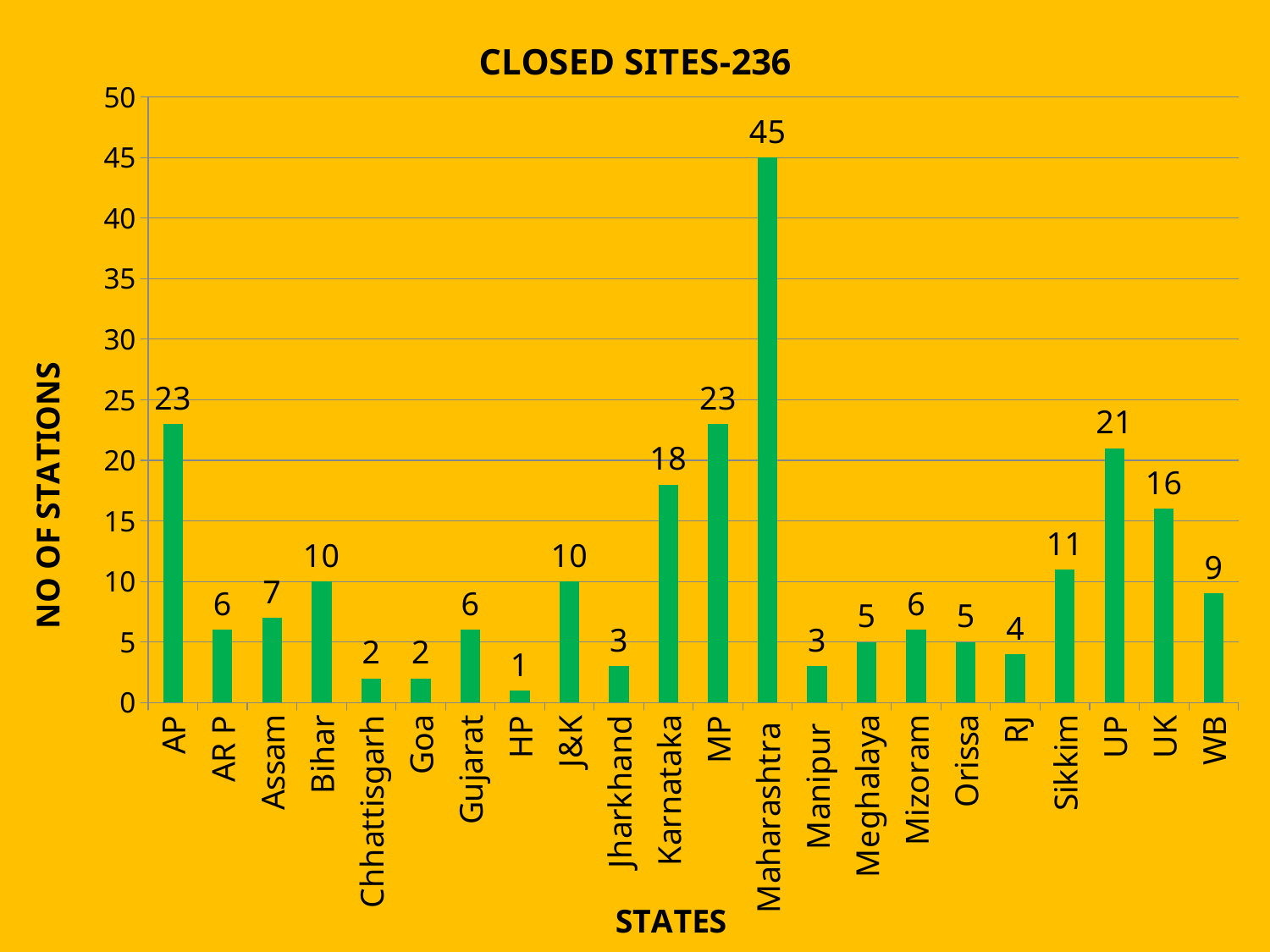
What is the number of closed stations for WB? 9 What is the number of closed stations for Karnataka? 18 What type of chart is shown on the slide? Bar chart What is the difference between the number of closed stations in Maharashtra and UP? 24 What is the number of closed stations for Maharashtra? 45 How many states are shown on the x axis of the chart? 22 Which state has the highest number of closed stations? Maharashtra What is the difference between the number of closed stations in UK and Sikkim? 5 Which state has the lowest number of closed stations? HP What is the number of closed stations for Sikkim? 11 Which has more closed stations, Bihar or Assam? Bihar What is the title of the chart? CLOSED SITES-236